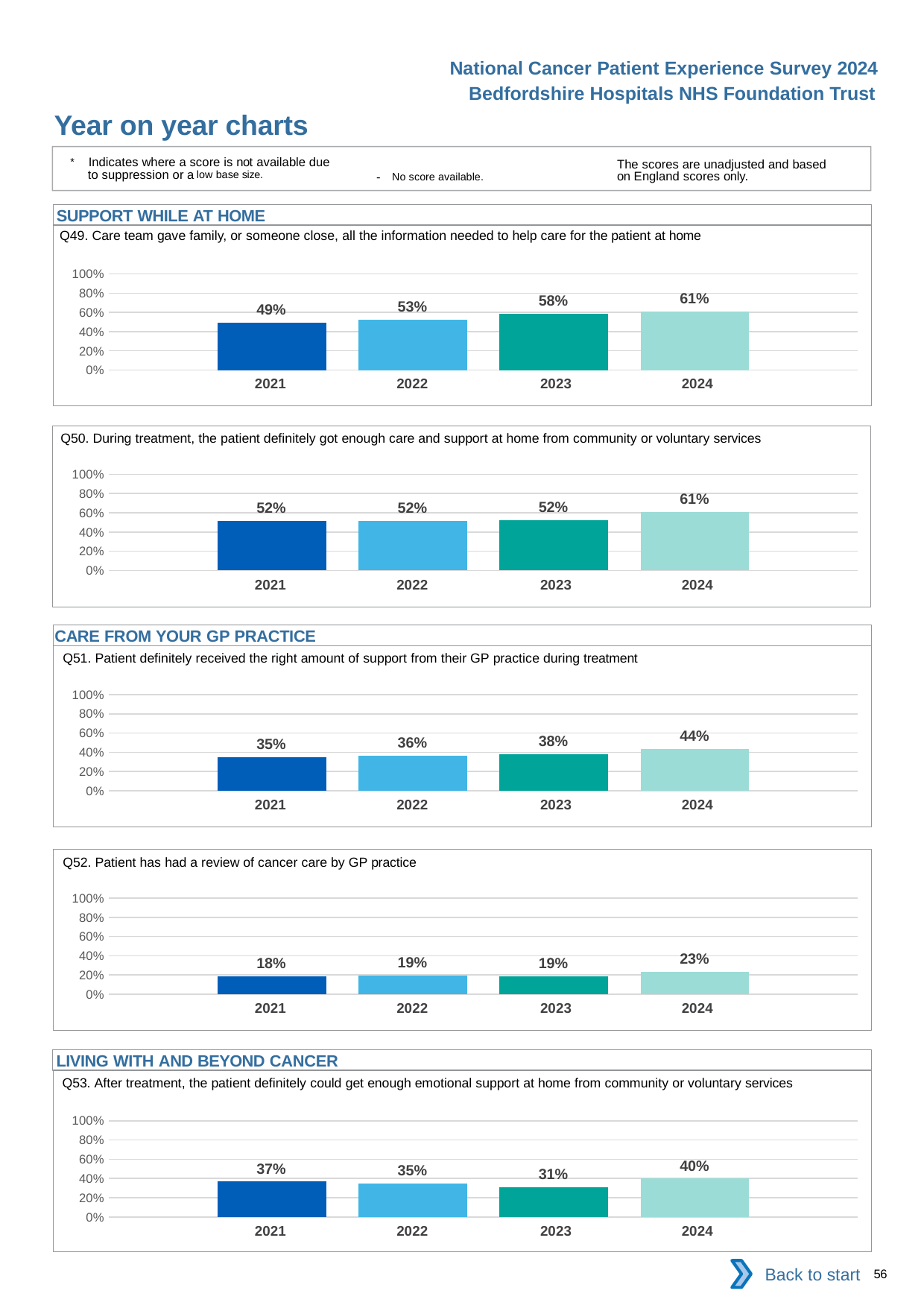
In the Q53 chart, which is larger, the value for 2021 or the value for 2022? 2021 In the Q51 chart, which year has the highest value? 2024 In the Q50 chart, what is the value for 2022? 52% How many years are shown on the x axis of the Q53 chart? 4 In the Q50 chart, what is the difference between the 2024 value and the 2023 value? 9% In the Q49 chart, which year has the lowest value? 2021 In the Q53 chart, which year has the lowest value? 2023 In the Q52 chart, is the value for 2024 greater or less than 40%? less In the Q49 chart, what is the value for 2024? 61% In the Q51 chart, do the values rise or fall from 2021 to 2024? rise In the Q52 chart, what is the value for 2021? 18% What kind of chart is the Q49 chart? bar chart